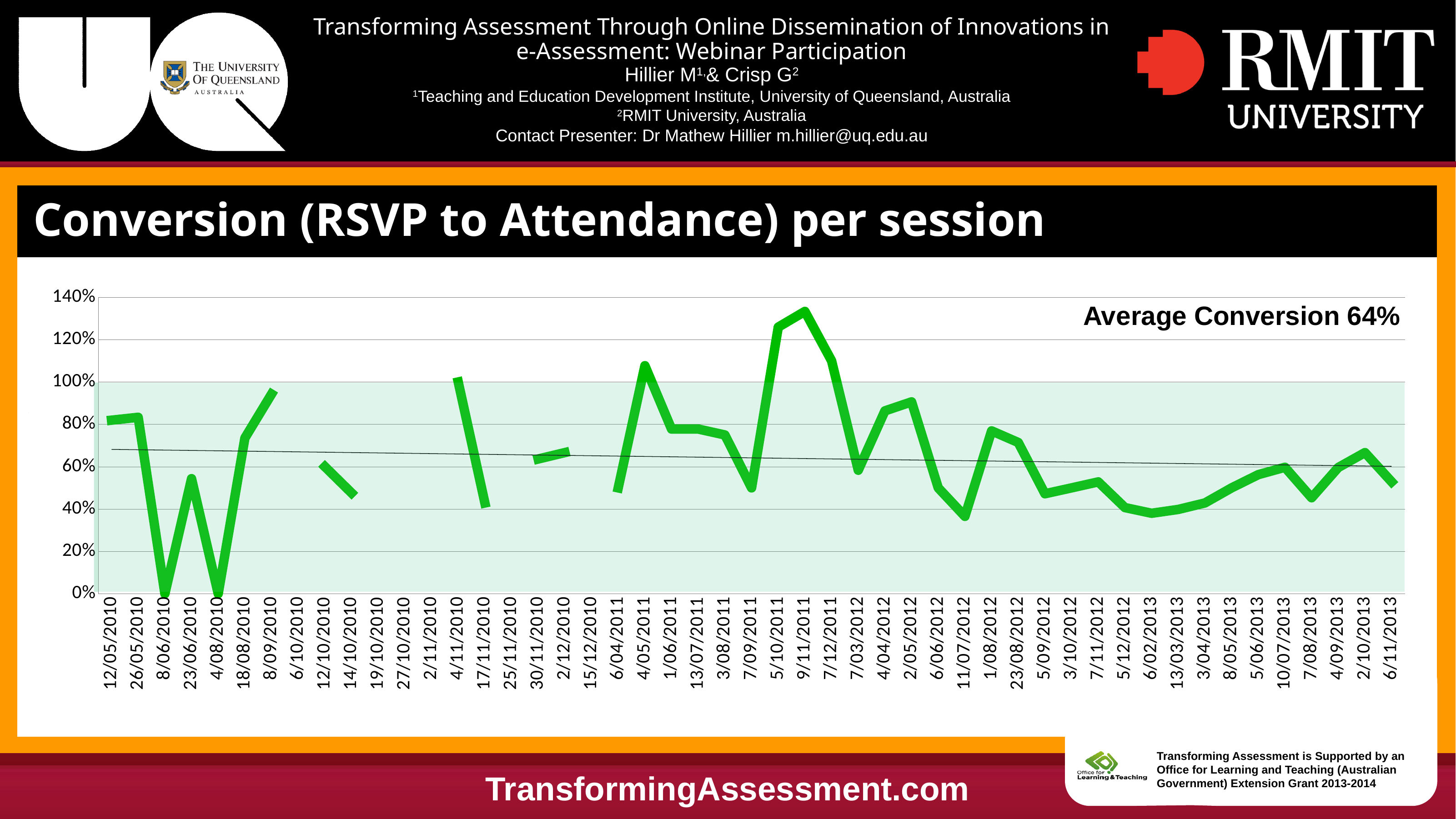
Which session has the higher conversion rate, 9/11/2011 or 4/05/2011? 9/11/2011 Is the conversion rate for 7/09/2011 greater or less than 60%? less What is the conversion rate for the 8/06/2010 session? 0% What average conversion rate is printed on the chart? 64% What is the title of the chart? Conversion (RSVP to Attendance) per session What is the conversion rate for the 4/08/2010 session? 0% What kind of chart is shown on the slide? line chart Is the conversion rate for 4/05/2011 greater or less than 100%? greater Which session date has the highest conversion rate? 9/11/2011 Is the conversion rate for 9/11/2011 greater or less than 120%? greater How many session dates are shown on the x axis? 49